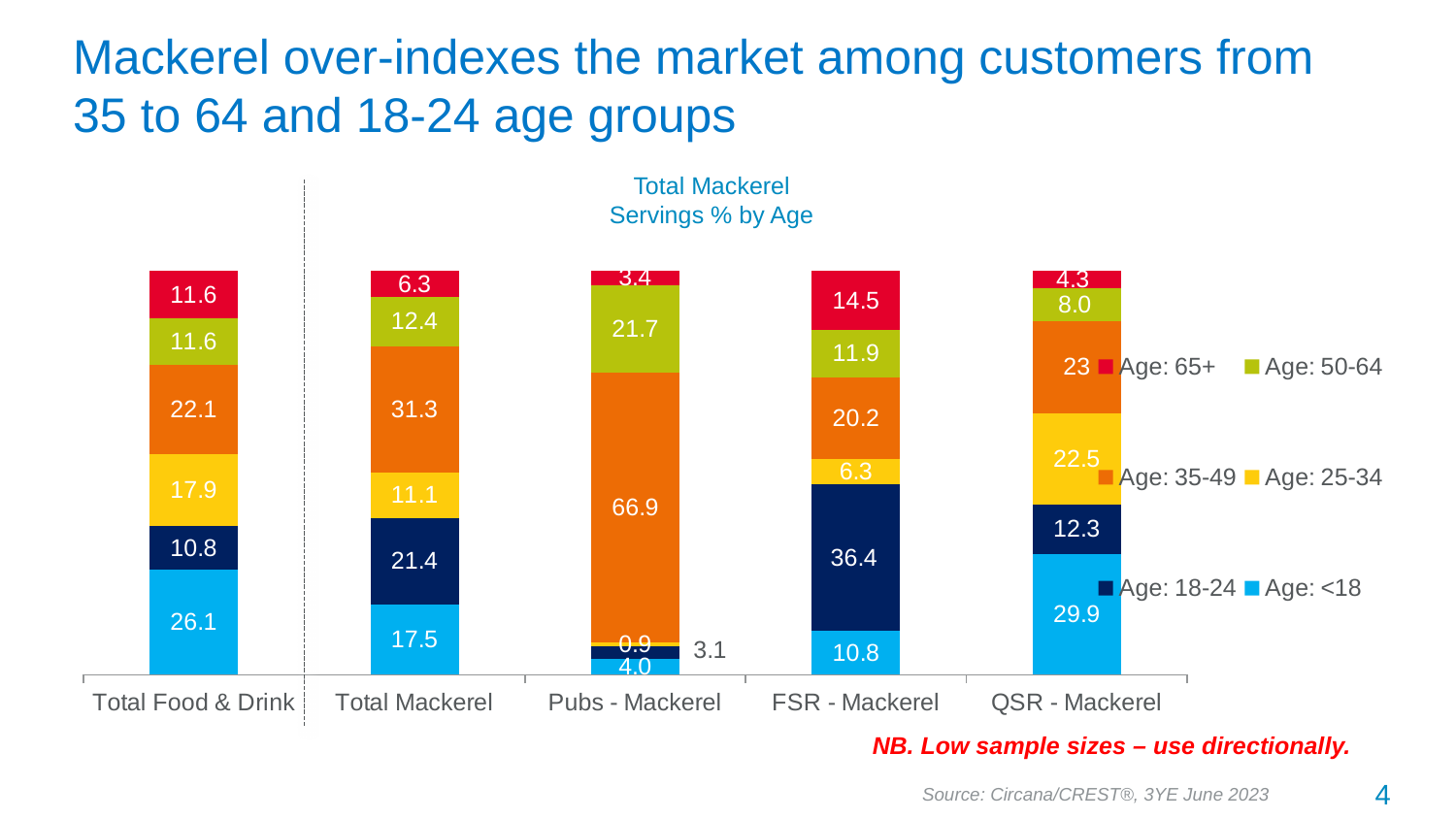
Which category has the highest Age: 35-49 value? Pubs - Mackerel What is the difference between the Age: 65+ values for FSR - Mackerel and Total Mackerel? 8.2 What is the Age: 18-24 value for FSR - Mackerel? 36.4 Which is larger for Age: 18-24, Total Mackerel or Total Food & Drink? Total Mackerel What is the Age: <18 value for QSR - Mackerel? 29.9 What is the Age: 35-49 value for Pubs - Mackerel? 66.9 What kind of chart is shown on the slide? Stacked bar chart Which category has the lowest Age: 65+ value? Pubs - Mackerel What is the Age: 25-34 value for Total Food & Drink? 17.9 What is the Age: 35-49 value for Total Mackerel? 31.3 How many categories are shown on the x axis? 5 How many series does the legend list? 6